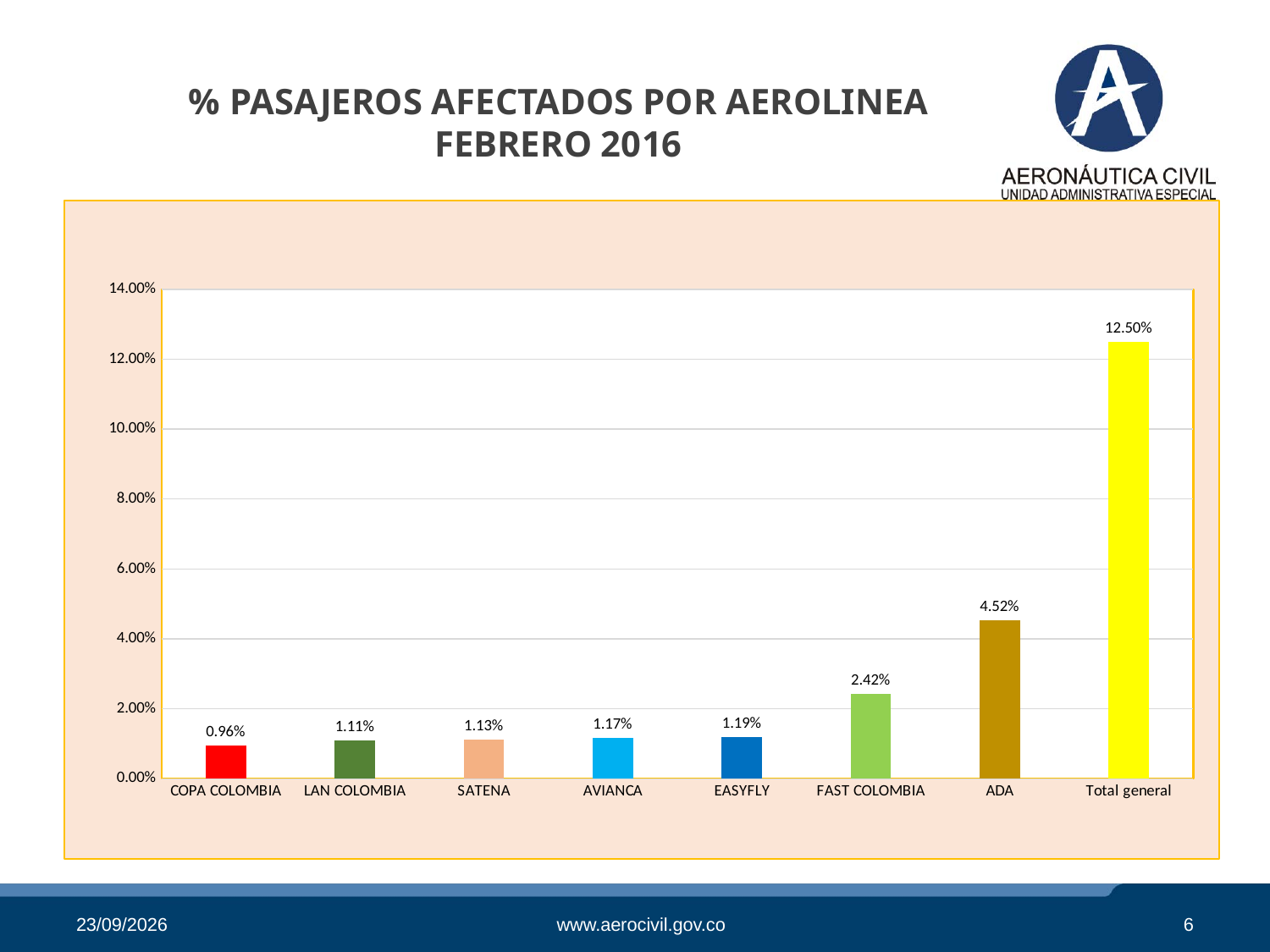
Is the value for Total general greater or less than 12.00%? greater How many categories are shown on the x axis? 8 What is the value for COPA COLOMBIA? 0.96% Which category has the highest value? Total general Which category has the lowest value? COPA COLOMBIA What is the value for FAST COLOMBIA? 2.42% What is the value for Total general? 12.50% Which is larger, the value for EASYFLY or the value for SATENA? EASYFLY What is the value for ADA? 4.52% What is the difference between the values for ADA and FAST COLOMBIA? 2.10% What is the title of the slide? % PASAJEROS AFECTADOS POR AEROLINEA FEBRERO 2016 What kind of chart is shown on the slide? bar chart